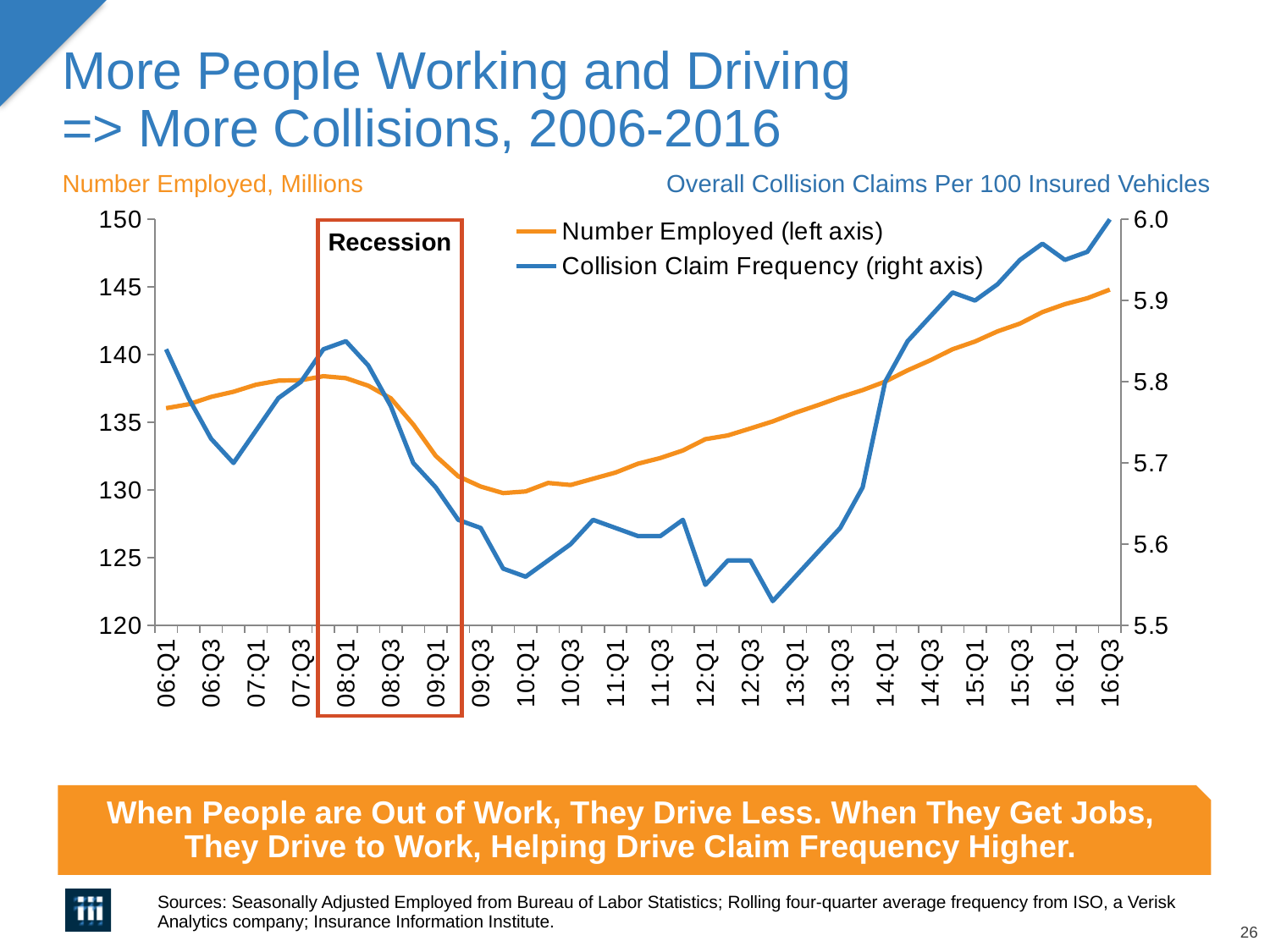
Which series is plotted against the left axis? Number Employed Is the value for Collision Claim Frequency at 13:Q1 greater or less than 5.7? less What label appears inside the red box on the chart? Recession What kind of chart is shown on the slide? Line chart Which is larger, Number Employed at 08:Q1 or at 10:Q1? 08:Q1 Is the value for Collision Claim Frequency at 16:Q3 greater or less than 5.9? greater Is the value for Number Employed at 16:Q3 greater or less than 140? greater How many series does the legend list? 2 Does Number Employed rise or fall from 10:Q1 to 16:Q3? rise At which quarter is Collision Claim Frequency highest? 16:Q3 At which quarter is Number Employed highest? 16:Q3